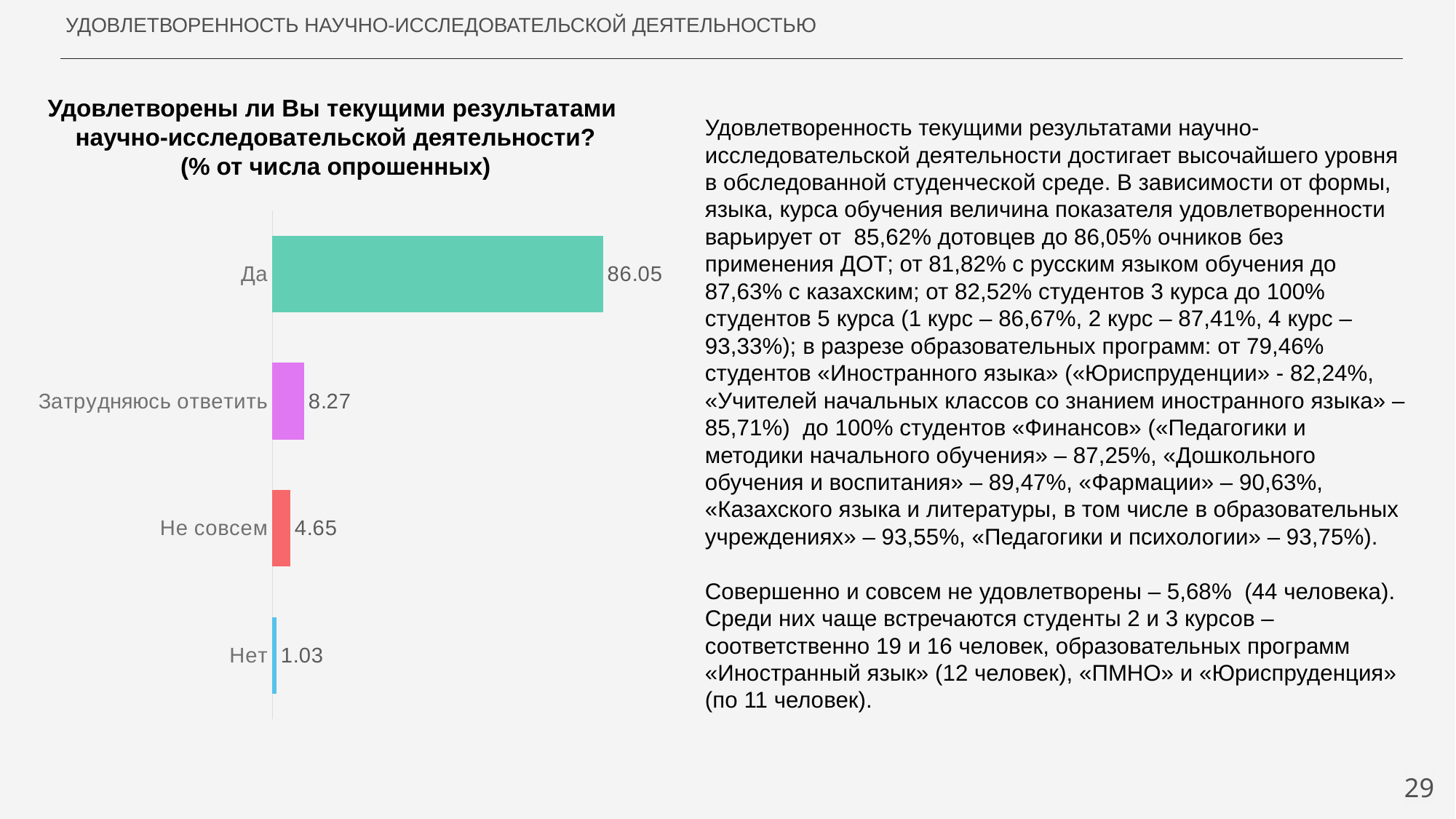
What is the value for "Нет"? 1.03 Which category has the highest value? Да What is the value for "Не совсем"? 4.65 Which is larger, the value for "Затрудняюсь ответить" or the value for "Не совсем"? Затрудняюсь ответить How many categories are shown in the chart? 4 What colour is the bar for "Да"? Green What is the value for "Да"? 86.05 What is the difference between the values for "Не совсем" and "Нет"? 3.62 Which category has the lowest value? Нет What is the value for "Затрудняюсь ответить"? 8.27 What is the difference between the values for "Да" and "Затрудняюсь ответить"? 77.78 What kind of chart is shown on the slide? Bar chart